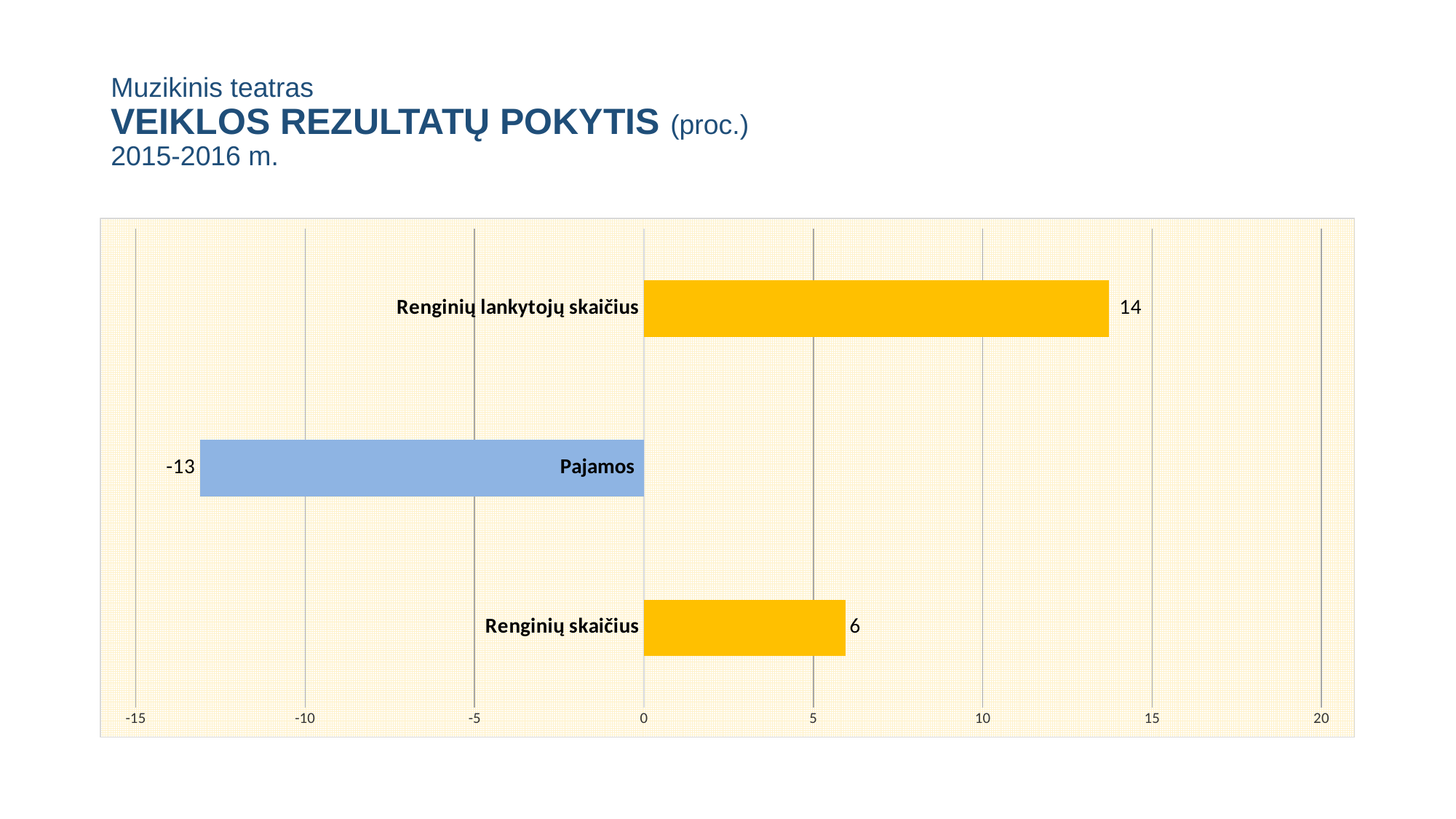
What is the value for Pajamos? -13 Which category is shown with a blue bar? Pajamos Is the value for Renginių lankytojų skaičius greater or less than 10? greater Which category has the highest value? Renginių lankytojų skaičius What kind of chart is shown on the slide? bar chart What is the difference between the values for Renginių skaičius and Pajamos? 19 How many categories are shown in the chart? 3 What is the value for Renginių skaičius? 6 Which is larger, the value for Renginių lankytojų skaičius or the value for Renginių skaičius? Renginių lankytojų skaičius What is the value for Renginių lankytojų skaičius? 14 Which category has the lowest value? Pajamos What is the difference between the values for Renginių lankytojų skaičius and Renginių skaičius? 8